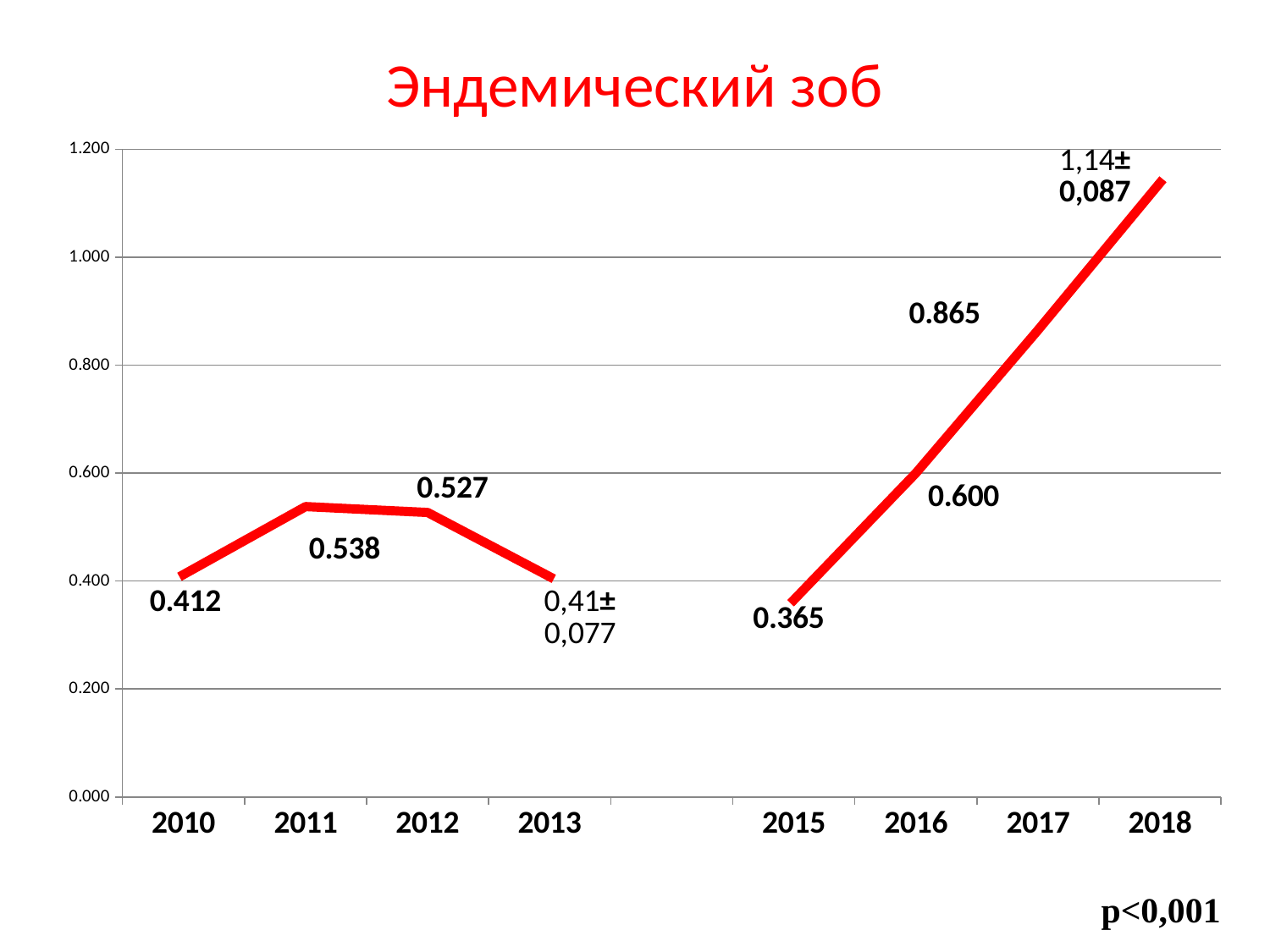
What is the data label shown for 2013? 0,41±0,077 Do the values rise or fall from 2015 to 2018? rise What is the value for 2017? 0.865 What is the difference between the values for 2017 and 2016? 0.265 What is the value for 2011? 0.538 What is the value for 2010? 0.412 What is the data label shown for 2018? 1,14±0,087 What is the difference between the values for 2011 and 2010? 0.126 Which year has the highest value? 2018 What is the title of the chart? Эндемический зоб Which is larger, the value for 2012 or the value for 2016? 2016 Which year has the lowest value? 2015